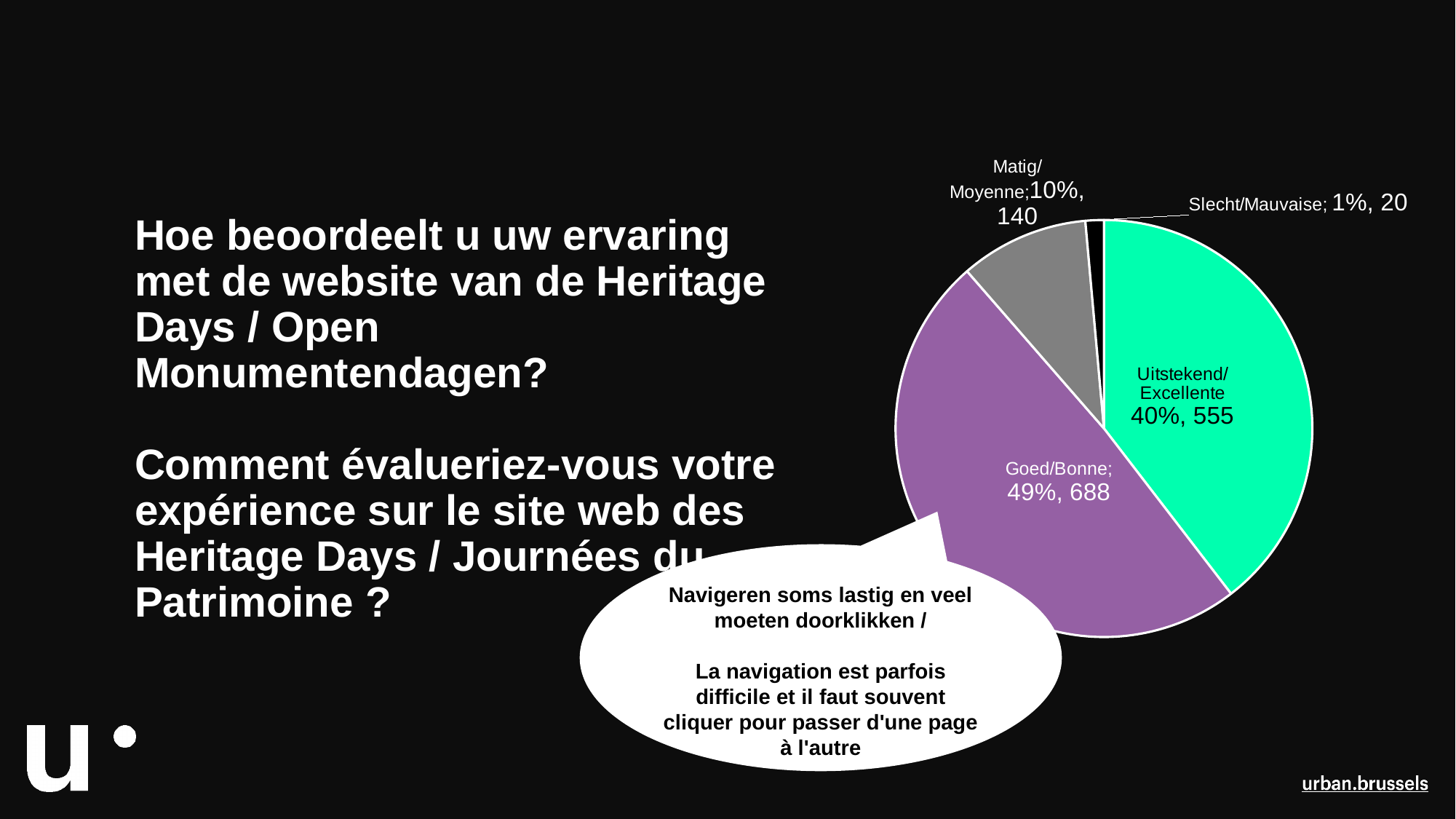
What is the count for Matig/Moyenne in the pie chart? 140 What is the count for Goed/Bonne in the pie chart? 688 What colour is the Goed/Bonne slice in the pie chart? Purple What is the difference in count between Goed/Bonne and Uitstekend/Excellente? 133 What percentage share does Slecht/Mauvaise have in the pie chart? 1% How many slices does the pie chart have? 4 Which category has the largest slice in the pie chart? Goed/Bonne What is the count for Uitstekend/Excellente in the pie chart? 555 What percentage share does Uitstekend/Excellente have in the pie chart? 40% Which has a larger count, Matig/Moyenne or Slecht/Mauvaise? Matig/Moyenne What kind of chart is shown on the slide? Pie chart Which category has the smallest slice in the pie chart? Slecht/Mauvaise